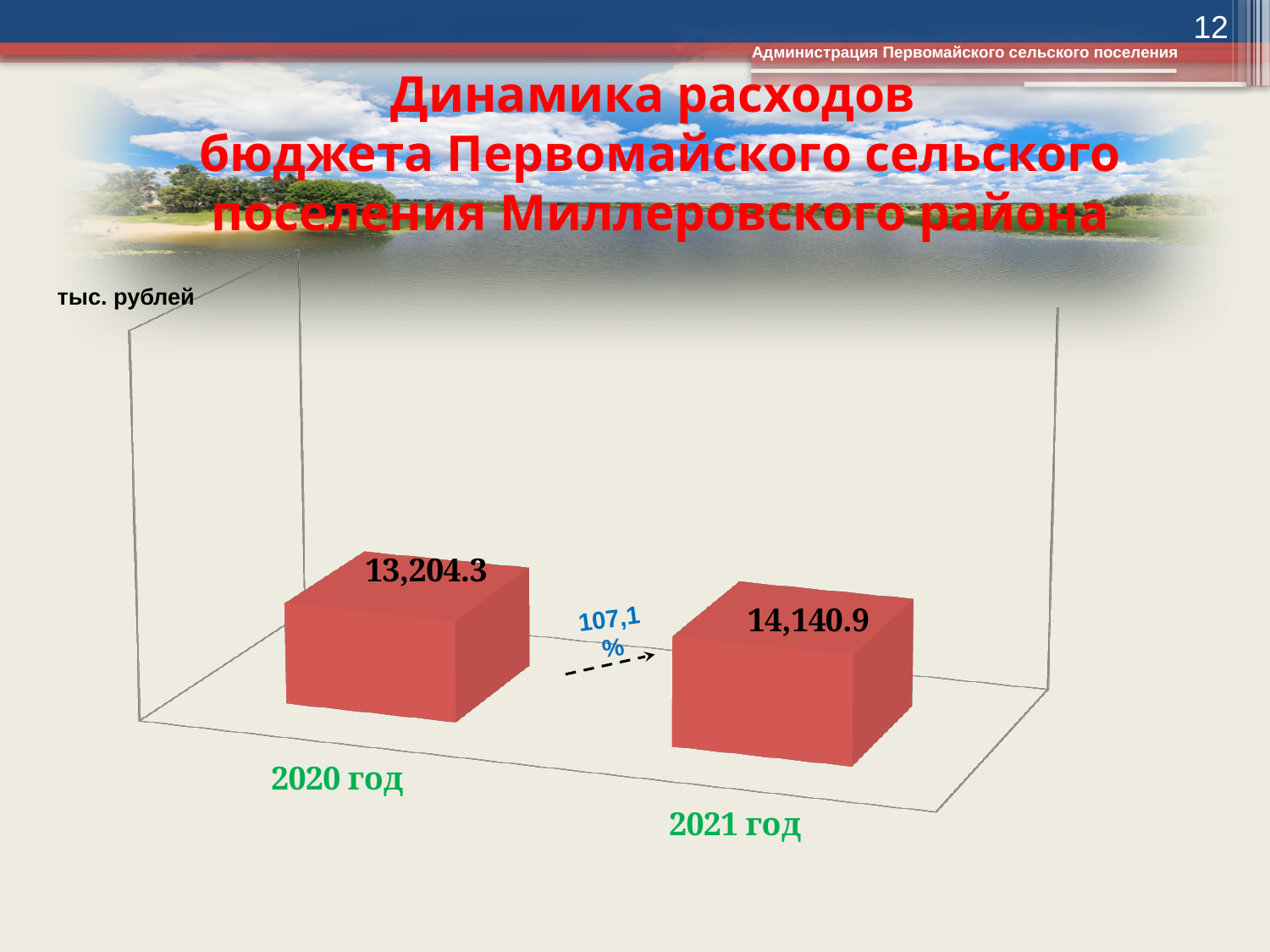
Which year has the highest value? 2021 год What is the difference between the values for 2021 год and 2020 год? 936.6 What percentage is shown on the arrow between the two bars? 107,1 % How many categories (years) are shown in the chart? 2 What is the value for 2021 год? 14,140.9 Do the values rise or fall from 2020 год to 2021 год? rise What kind of chart is shown on the slide? bar chart What colour are the bars in the chart? red Which year has the lowest value? 2020 год What unit of measurement is indicated for the chart? тыс. рублей What is the value for 2020 год? 13,204.3 Which is larger, the value for 2020 год or the value for 2021 год? 2021 год